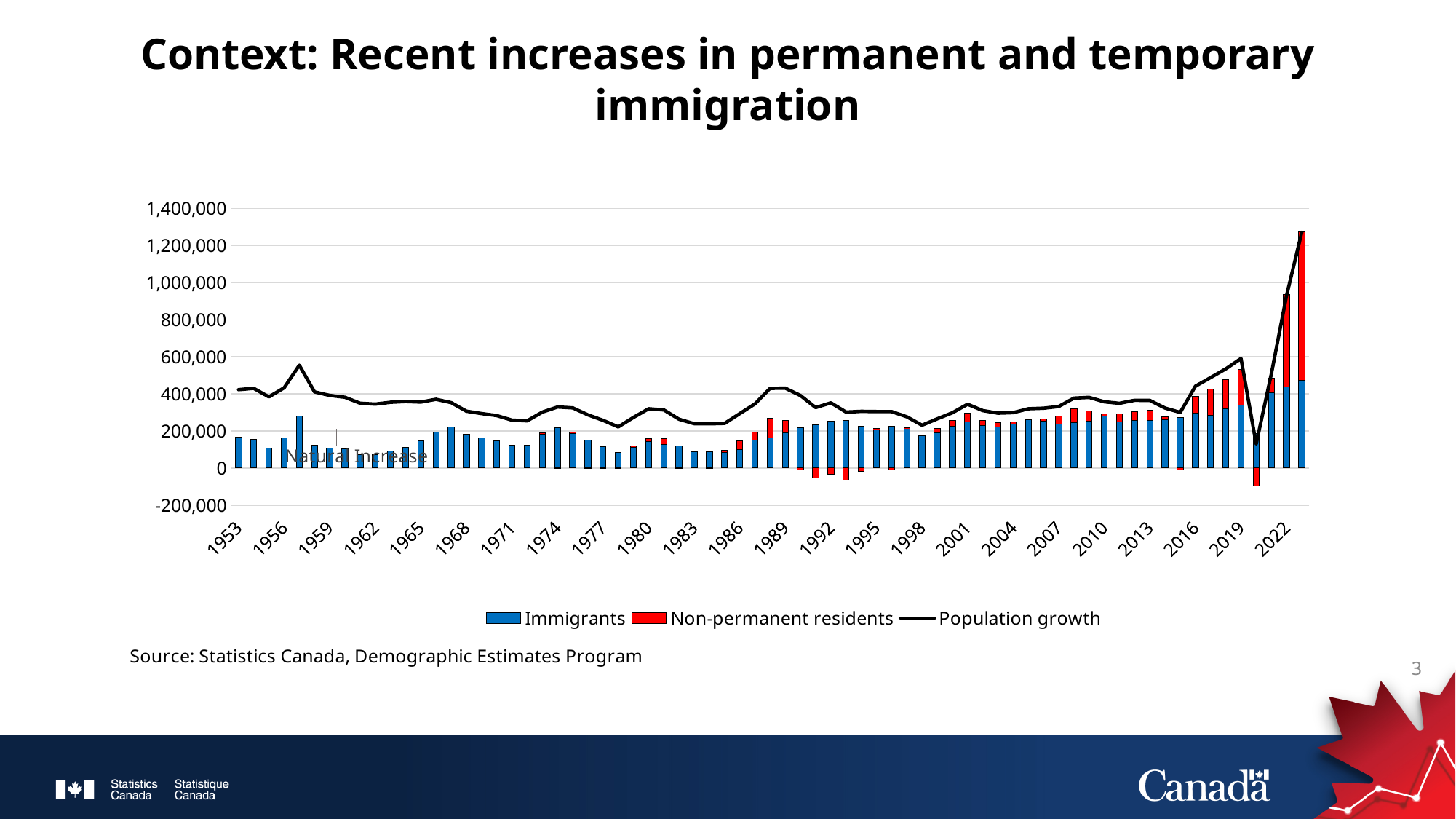
Is the value of Population growth in 2019 greater or less than 400,000? greater Does Population growth rise or fall from 2016 to 2019? Rise Is the Immigrants value in 2022 greater or less than 200,000? greater How many series does the legend list? 3 What is the source cited below the chart? Statistics Canada, Demographic Estimates Program Is the value of Population growth in 2022 greater or less than 800,000? greater Which series is drawn as a black line? Population growth Does the Population growth line reach its highest value at the right end of the chart? Yes Which year has the larger Immigrants value, 1953 or 2022? 2022 What kind of chart is this? A combination chart of stacked bars with a line